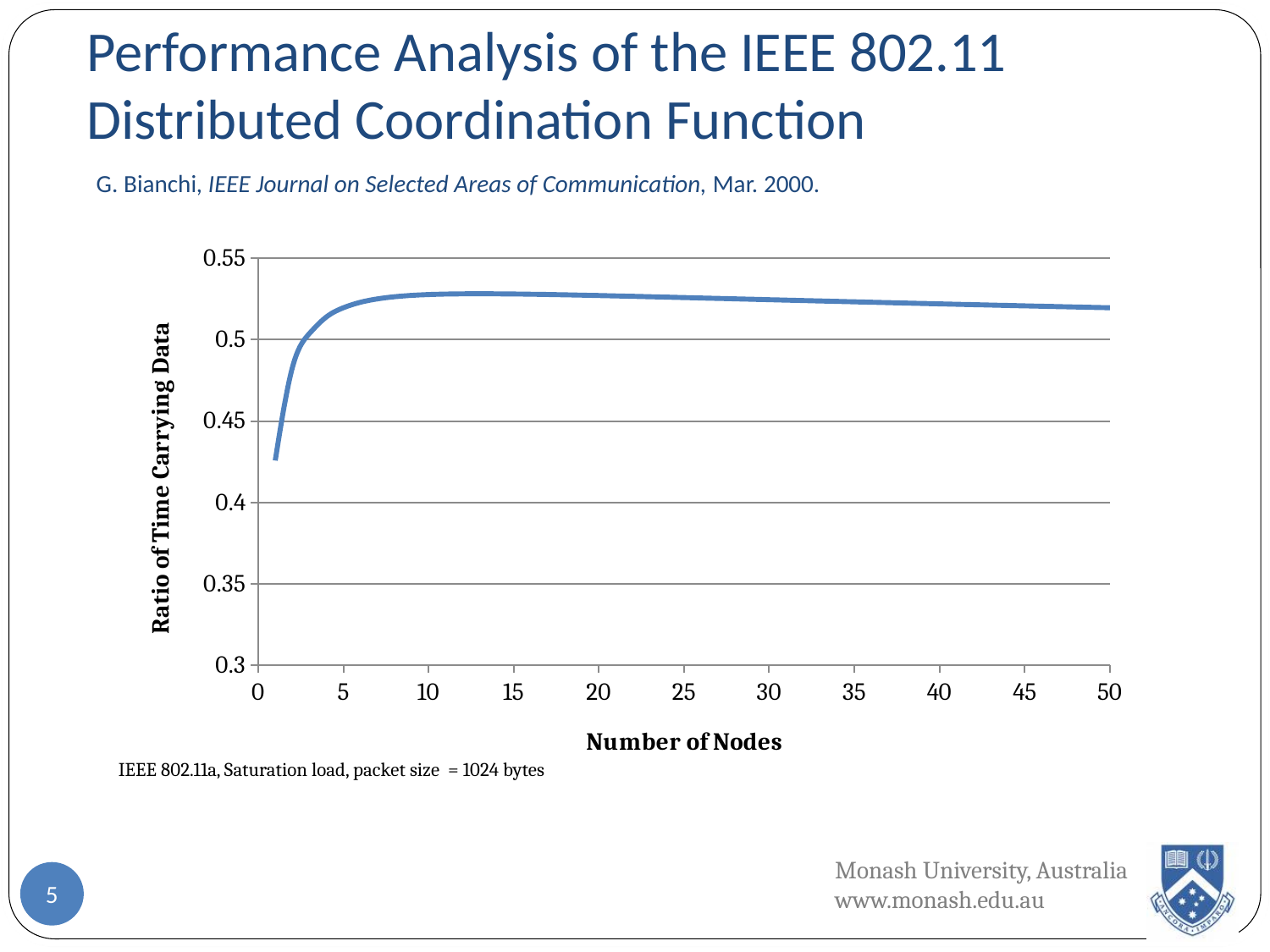
What kind of chart is shown on the slide? line chart What is the title of the y axis of the chart? Ratio of Time Carrying Data Is the value for 1 node greater or less than 0.45? less Is the value for 50 nodes greater or less than 0.5? greater How does the ratio of time carrying data change as the number of nodes increases from 1 to 50? rises sharply at first, then slowly declines Which is larger, the value at 1 node or the value at 50 nodes? 50 nodes Is the value for 30 nodes greater or less than 0.55? less At which number of nodes is the ratio of time carrying data lowest? 1 Which is larger, the value at 1 node or the value at 10 nodes? 10 nodes What is the title of the x axis of the chart? Number of Nodes